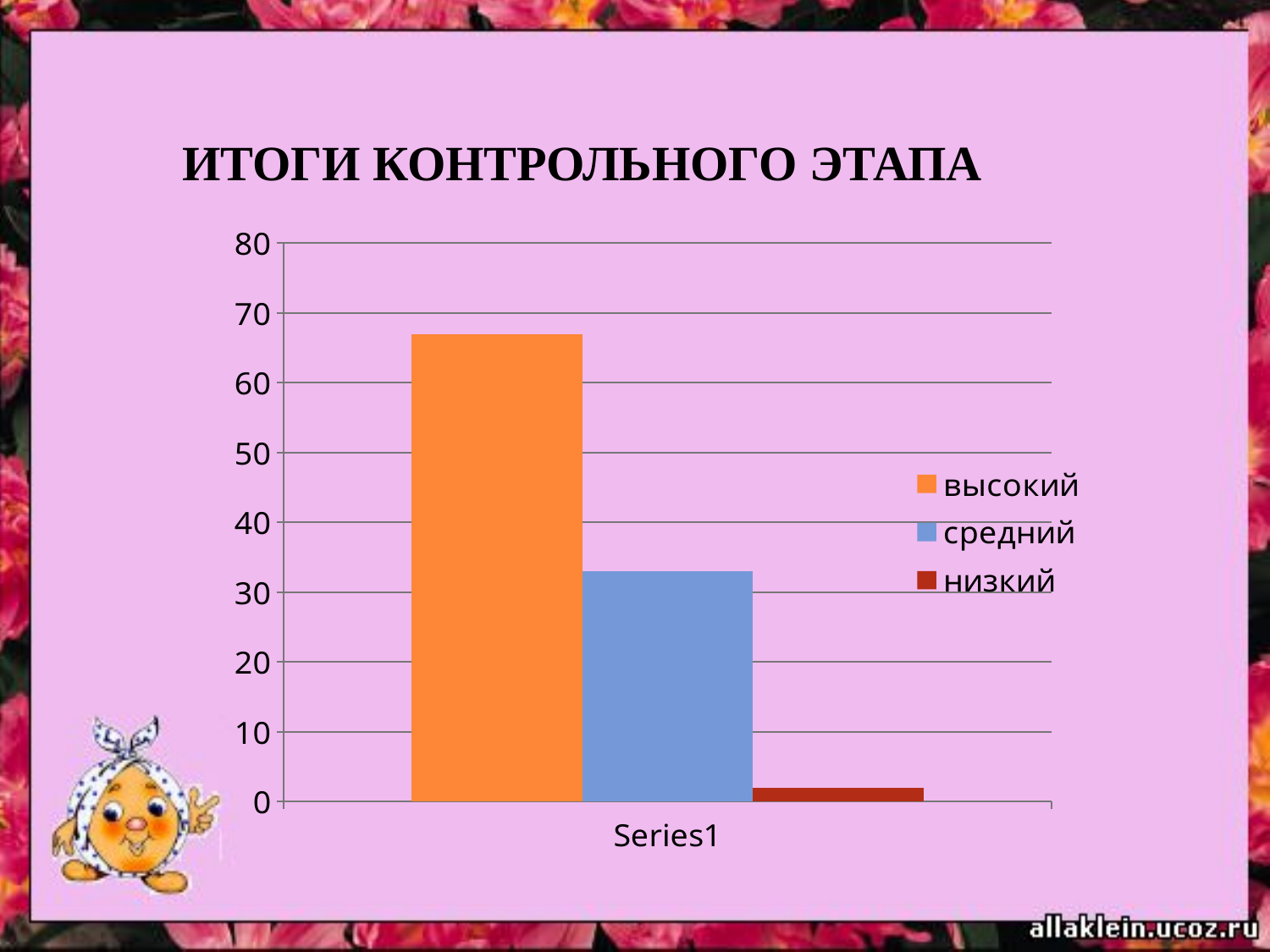
Is the value for средний greater or less than 40? less Which series has the lowest bar? низкий How many series does the legend list? 3 What kind of chart is shown on the slide? bar chart Which series has the highest bar? высокий What colour is the bar for средний? blue How many categories are shown on the x axis? 1 Is the value for низкий greater or less than 10? less Which is larger, the bar for высокий or the bar for средний? высокий Which is larger, the bar for средний or the bar for низкий? средний Is the value for высокий greater or less than 60? greater What is the title of the slide above the chart? ИТОГИ КОНТРОЛЬНОГО ЭТАПА